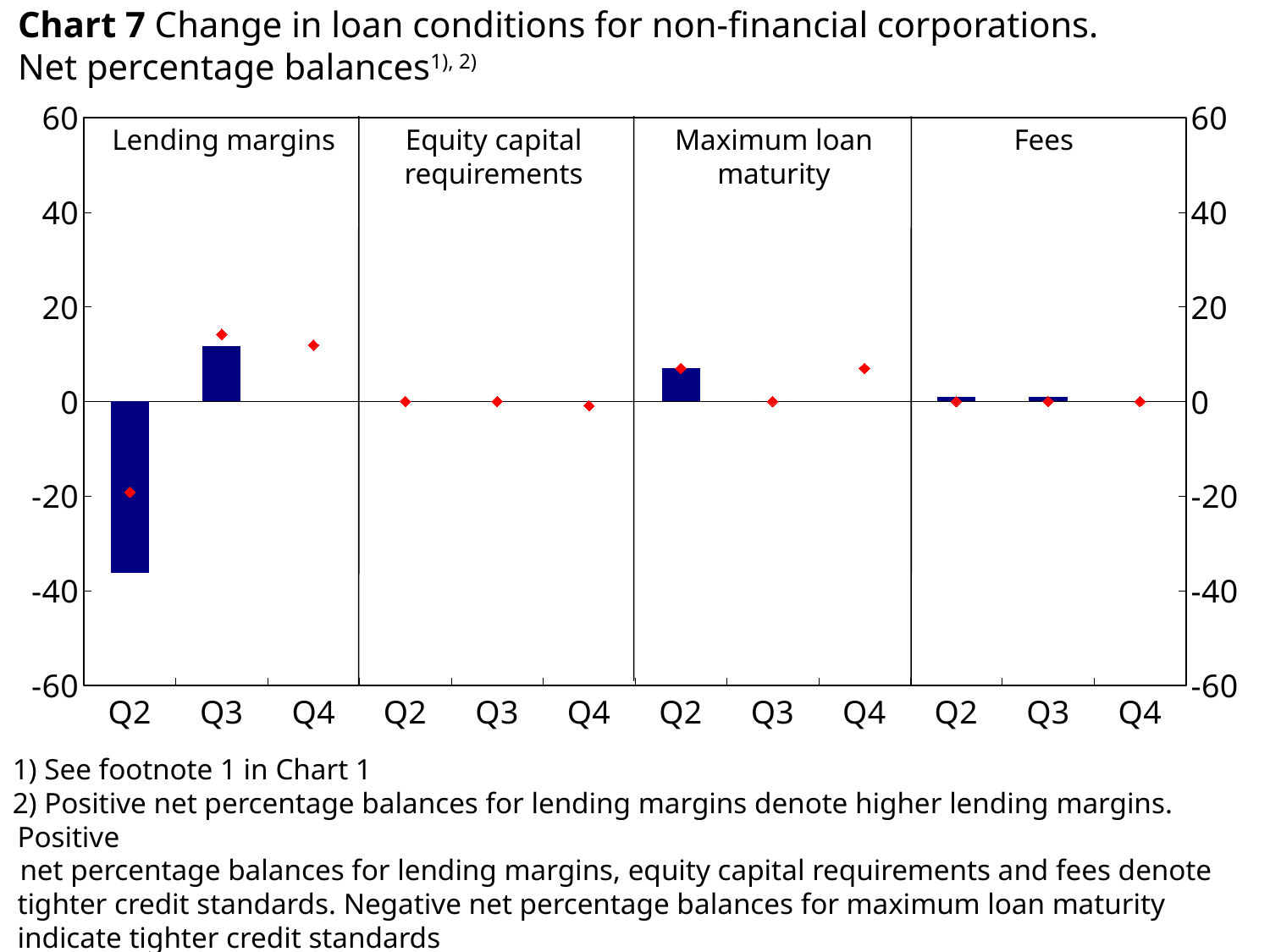
What are the four panel headings in Chart 7? Lending margins, Equity capital requirements, Maximum loan maturity, Fees In the Lending margins panel, is the Q3 bar greater or less than 20? less Which panel contains the lowest bar in Chart 7? Lending margins In the Lending margins panel, do the bars rise or fall from Q2 to Q3? rise What kind of chart is Chart 7? bar chart In the Maximum loan maturity panel, is the Q2 bar greater or less than 0? greater In the Lending margins panel for Q2, which is higher, the bar or the red marker? the red marker What is the range of the vertical axis in Chart 7? -60 to 60 How many quarters are shown on the x axis within each panel of Chart 7? 3 In the Lending margins panel, which bar is larger, Q2 or Q3? Q3 In the Lending margins panel, is the Q2 bar greater or less than -20? less How many panels (loan condition categories) does Chart 7 show? 4